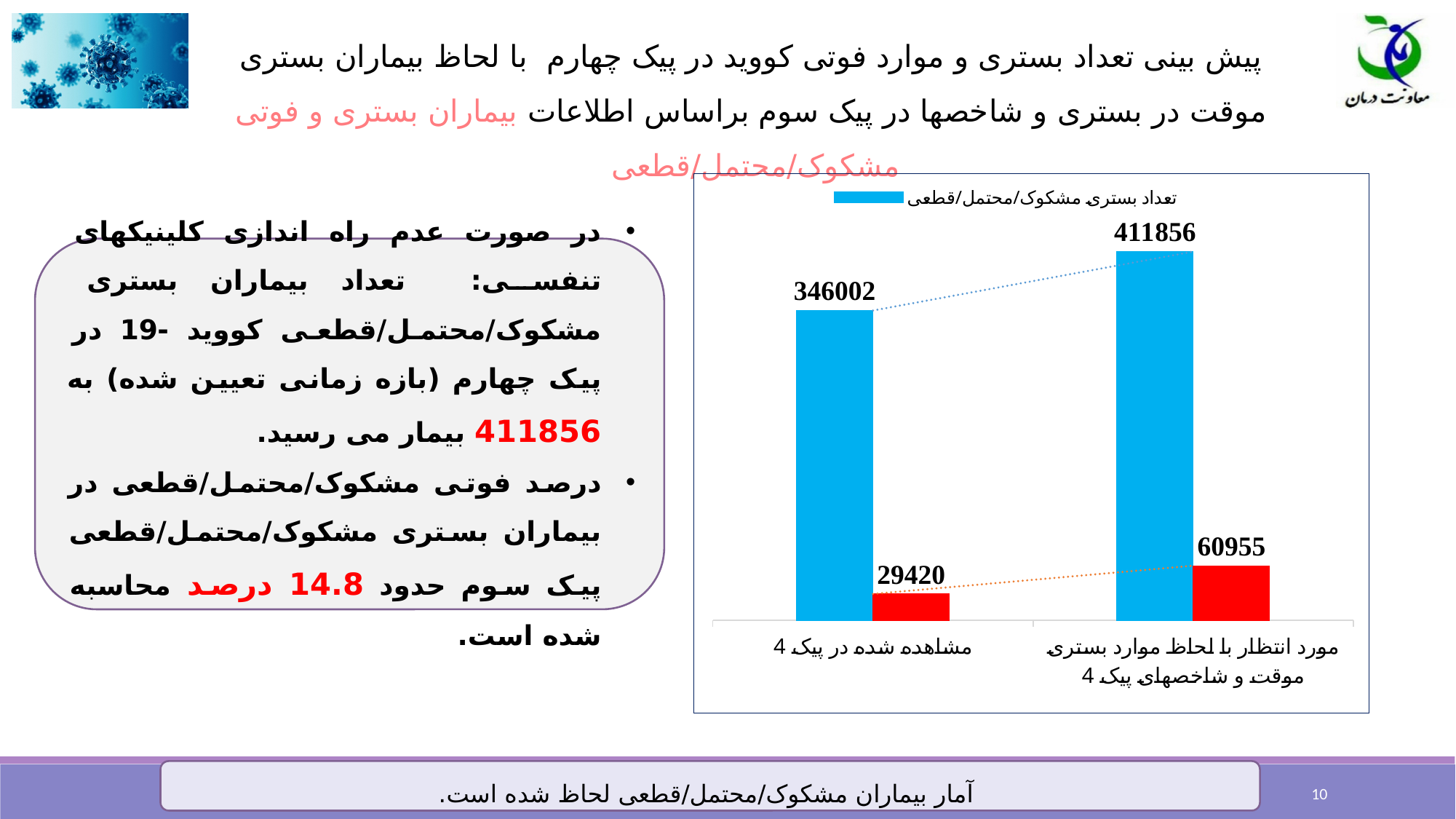
Which is larger: the red bar for 'مشاهده شده در پیک 4' or the red bar for 'مورد انتظار با لحاظ موارد بستری موقت و شاخصهای پیک 4'? مورد انتظار با لحاظ موارد بستری موقت و شاخصهای پیک 4 Which bar has the highest value in the chart? the blue bar for مورد انتظار با لحاظ موارد بستری موقت و شاخصهای پیک 4 (411856) What is the value of the red bar for the category 'مشاهده شده در پیک 4'? 29420 How many categories are shown on the x axis of the chart? 2 What is the difference between the two red bar values (60955 and 29420)? 31535 What is the value of the red bar for the category 'مورد انتظار با لحاظ موارد بستری موقت و شاخصهای پیک 4'? 60955 Which bar has the lowest value in the chart? the red bar for مشاهده شده در پیک 4 (29420) What is the value of the blue bar for the category 'مشاهده شده در پیک 4'? 346002 What is the difference between the two blue bar values (411856 and 346002)? 65854 What type of chart is shown on the slide? bar chart What is the value of the blue bar for the category 'مورد انتظار با لحاظ موارد بستری موقت و شاخصهای پیک 4'? 411856 What is the legend entry shown for the blue series? تعداد بستری مشکوک/محتمل/قطعی